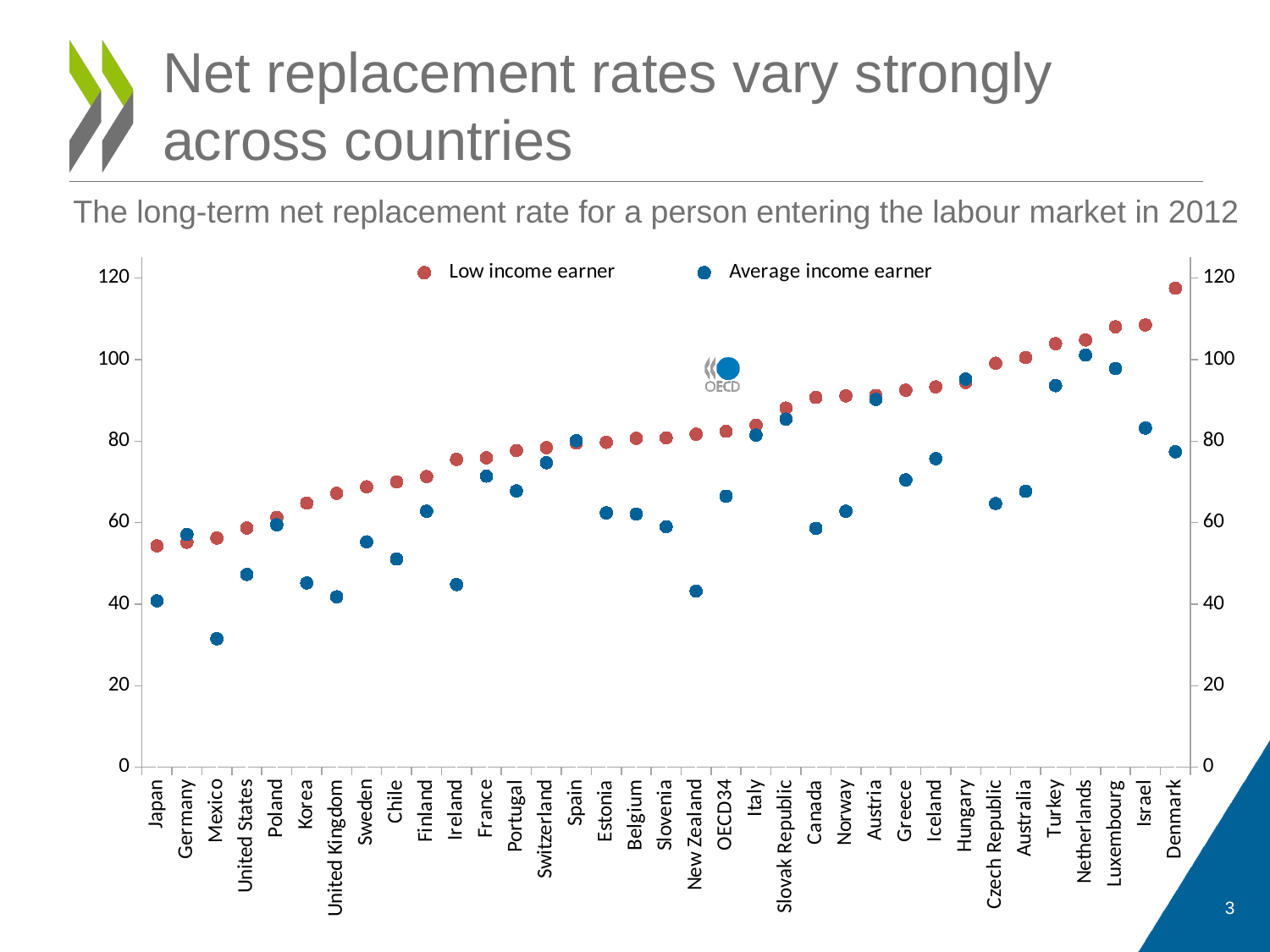
Is the Average income earner value for New Zealand greater or less than 60? less Which country has the lowest value for the Average income earner series? Mexico What kind of chart is shown on the slide? Scatter (dot) chart Do the Low income earner values rise or fall moving from left to right along the x axis? Rise How many series does the legend list? 2 How many countries or groups are shown along the x axis? 35 Is the Low income earner value for Denmark greater or less than 100? greater For Denmark, which is larger: the Low income earner value or the Average income earner value? Low income earner Is the Average income earner value for Mexico greater or less than 40? less What colour are the markers for the Low income earner series? Red Which country has the highest value for the Low income earner series? Denmark Which country has the lowest value for the Low income earner series? Japan